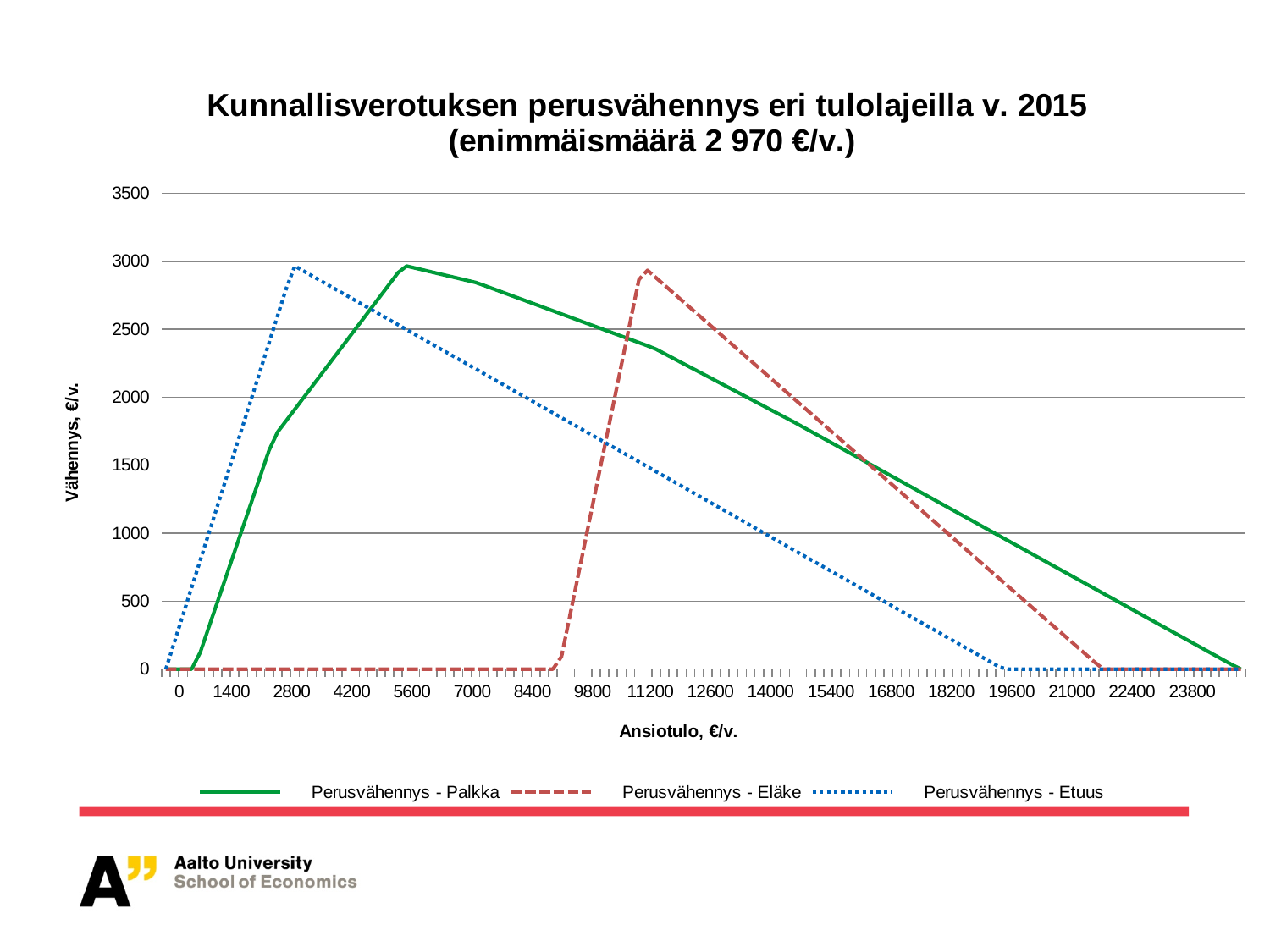
What kind of chart is shown on the slide? line chart Is the value of Perusvähennys - Etuus at an income of 9800 greater or less than 1500? greater Which series is drawn with a dotted blue line? Perusvähennys - Etuus Is the value of Perusvähennys - Eläke at an income of 7000 greater or less than 500? less Is the value of Perusvähennys - Palkka at an income of 5600 greater or less than 2500? greater At an income of 14000, which series has the larger value: Perusvähennys - Palkka or Perusvähennys - Etuus? Perusvähennys - Palkka Does the Perusvähennys - Etuus line rise or fall between incomes of 2800 and 19600? fall At an income of 7000, which series has the larger value: Perusvähennys - Palkka or Perusvähennys - Eläke? Perusvähennys - Palkka What is the title of the chart? Kunnallisverotuksen perusvähennys eri tulolajeilla v. 2015 (enimmäismäärä 2 970 €/v.) How many series does the legend list? 3